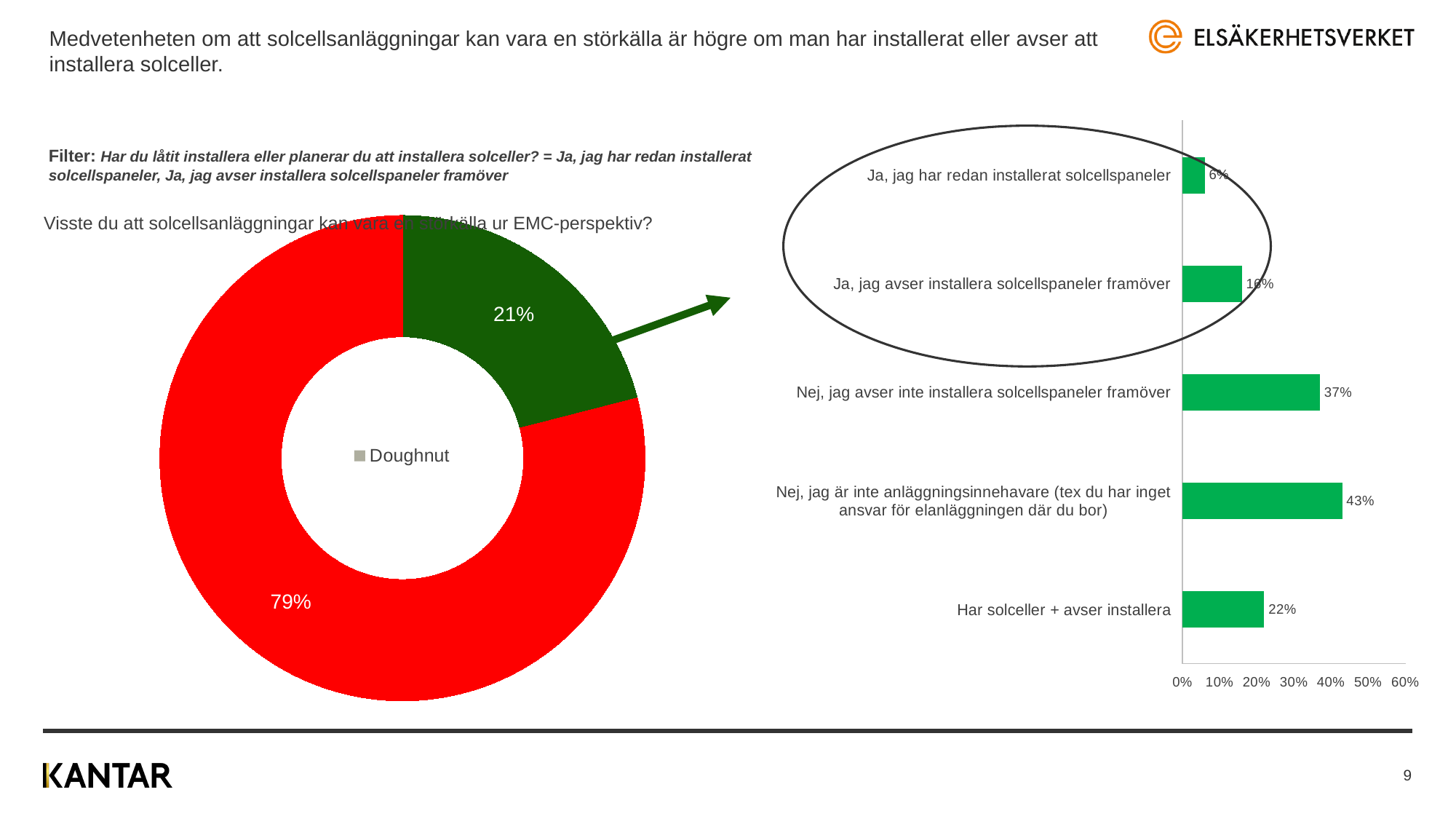
What type of chart is on the right side of the slide? Bar chart In the bar chart on the right, what is the value for 'Nej, jag avser inte installera solcellspaneler framöver'? 37% In the bar chart on the right, what is the difference between the values for 'Nej, jag är inte anläggningsinnehavare' and 'Nej, jag avser inte installera solcellspaneler framöver'? 6 percentage points In the bar chart on the right, what is the value for 'Ja, jag har redan installerat solcellspaneler'? 6% In the bar chart on the right, which category has the highest value? Nej, jag är inte anläggningsinnehavare (tex du har inget ansvar för elanläggningen där du bor) In the bar chart on the right, what is the value for 'Har solceller + avser installera'? 22% In the bar chart on the right, which category has the lowest value? Ja, jag har redan installerat solcellspaneler In the doughnut chart on the left, what is the legend entry shown in the centre? Doughnut In the bar chart on the right, is the value for 'Ja, jag avser installera solcellspaneler framöver' greater or less than 20%? less In the doughnut chart on the left, what percentage does the red slice show? 79% What type of chart is on the left side of the slide? Doughnut chart In the doughnut chart on the left, what percentage does the green slice show? 21%